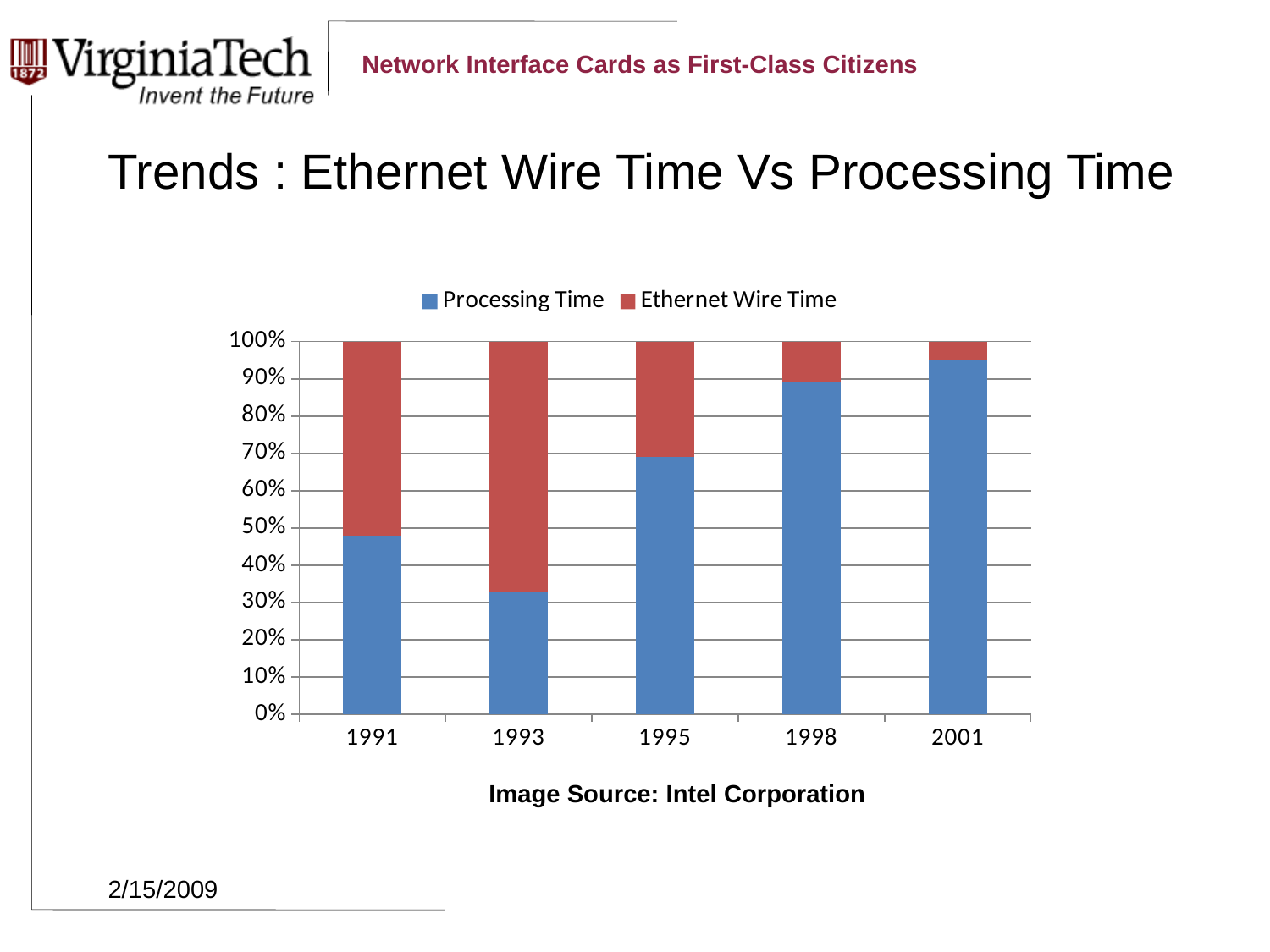
Is the Ethernet Wire Time share for 2001 greater or less than 10%? less Which year has the largest Ethernet Wire Time share? 1993 Which year has a larger Processing Time share, 1991 or 1995? 1995 From 1993 to 2001, does the Processing Time share rise or fall? rise Which colour represents Ethernet Wire Time in the legend? Red What kind of chart is shown on the slide? Stacked bar chart How many series does the legend list? 2 Is the Processing Time share for 1993 greater or less than 40%? less Is the Processing Time share for 1998 greater or less than 80%? greater Which year has the highest Processing Time share? 2001 Which year has the lowest Processing Time share? 1993 How many years are shown along the x axis? 5